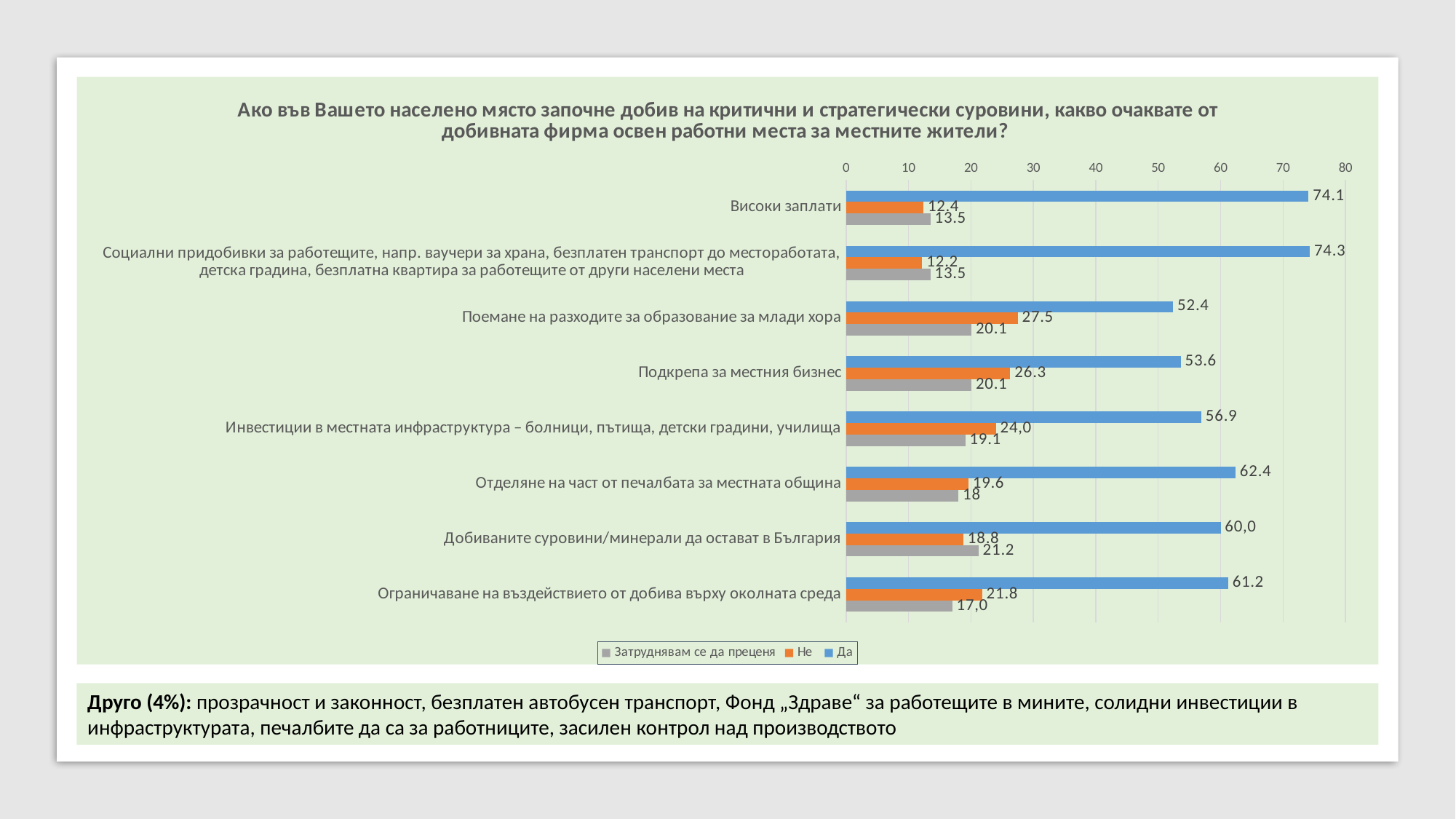
Which category has the highest value in the "Не" series? Поемане на разходите за образование за млади хора How many categories are shown in the chart? 8 How many series does the legend list? 3 What is the difference between the "Да" and "Не" values for "Високи заплати"? 61.7 What is the value of the "Да" series for "Ограничаване на въздействието от добива върху околната среда"? 61.2 What kind of chart is shown on the slide? Bar chart What is the value of the "Не" series for "Поемане на разходите за образование за млади хора"? 27.5 Which category has the highest value in the "Затруднявам се да преценя" series? Добиваните суровини/минерали да остават в България What is the value of the "Затруднявам се да преценя" series for "Добиваните суровини/минерали да остават в България"? 21.2 Which series is shown in orange in the legend? Не What is the value of the "Да" series for "Високи заплати"? 74.1 Which is larger: the "Да" value for "Подкрепа за местния бизнес" or the "Да" value for "Отделяне на част от печалбата за местната община"? Отделяне на част от печалбата за местната община